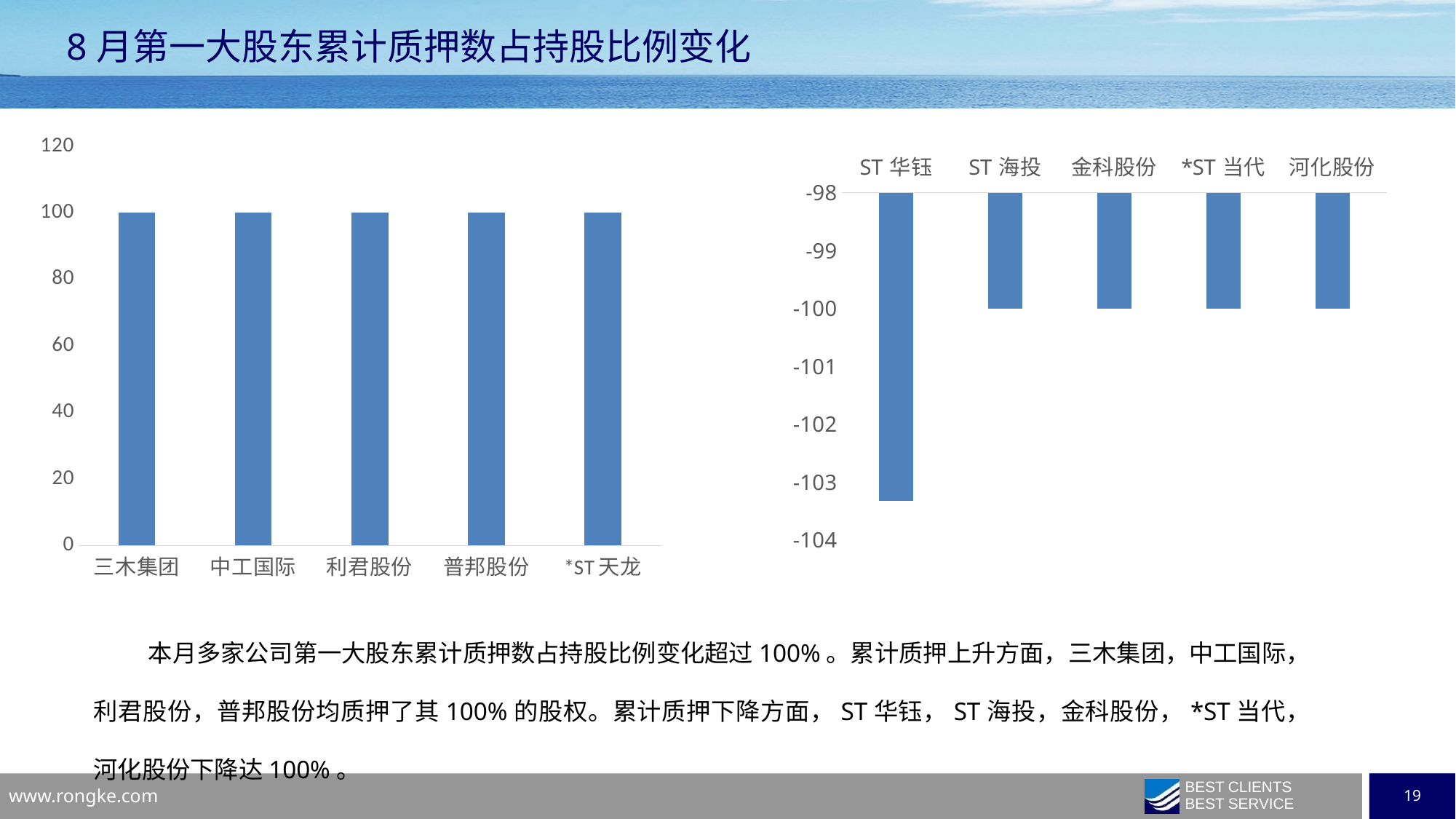
What is the title of the slide containing the charts? 8 月第一大股东累计质押数占持股比例变化 In the right chart, which category has the lowest value? ST 华钰 What kind of chart is the left chart on the slide? bar chart In the left chart, what is the value for 三木集团? 100 In the right chart, what is the value for 河化股份? -100 How many categories are shown in the right chart? 5 In the right chart, what is the value for ST 海投? -100 In the right chart, is the value for ST 华钰 greater or less than -103? less How many categories are shown in the left chart? 5 In the left chart, what is the value for *ST 天龙? 100 In the right chart, which is lower, the value for ST 华钰 or the value for *ST 当代? ST 华钰 In the right chart, is the value for 金科股份 greater or less than -102? greater